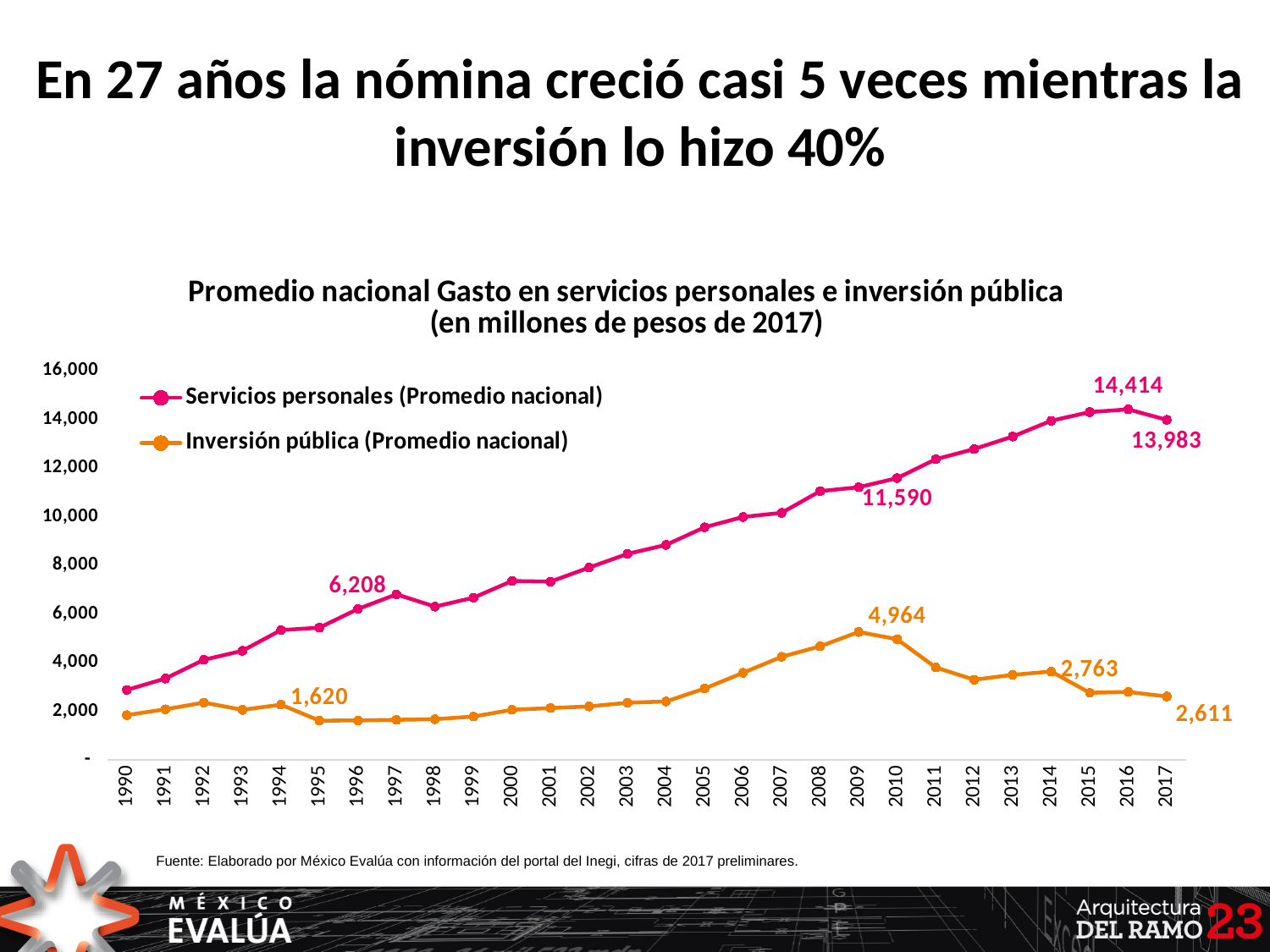
How many series does the legend list? 2 What is the value of Servicios personales (Promedio nacional) in 2017? 13,983 What type of chart is shown on the slide? line chart How many years are plotted along the x axis? 28 Is the value of Servicios personales (Promedio nacional) in 1990 greater or less than 4,000? less Is the value of Servicios personales (Promedio nacional) in 2005 greater or less than 8,000? greater What is the difference between Servicios personales and Inversión pública in 2017? 11,372 Which series has the higher value in 2017, Servicios personales or Inversión pública? Servicios personales What is the highest value reached by the Servicios personales (Promedio nacional) series? 14,414 In which year does the Servicios personales (Promedio nacional) series reach its highest value? 2016 What is the value of Inversión pública (Promedio nacional) in 2017? 2,611